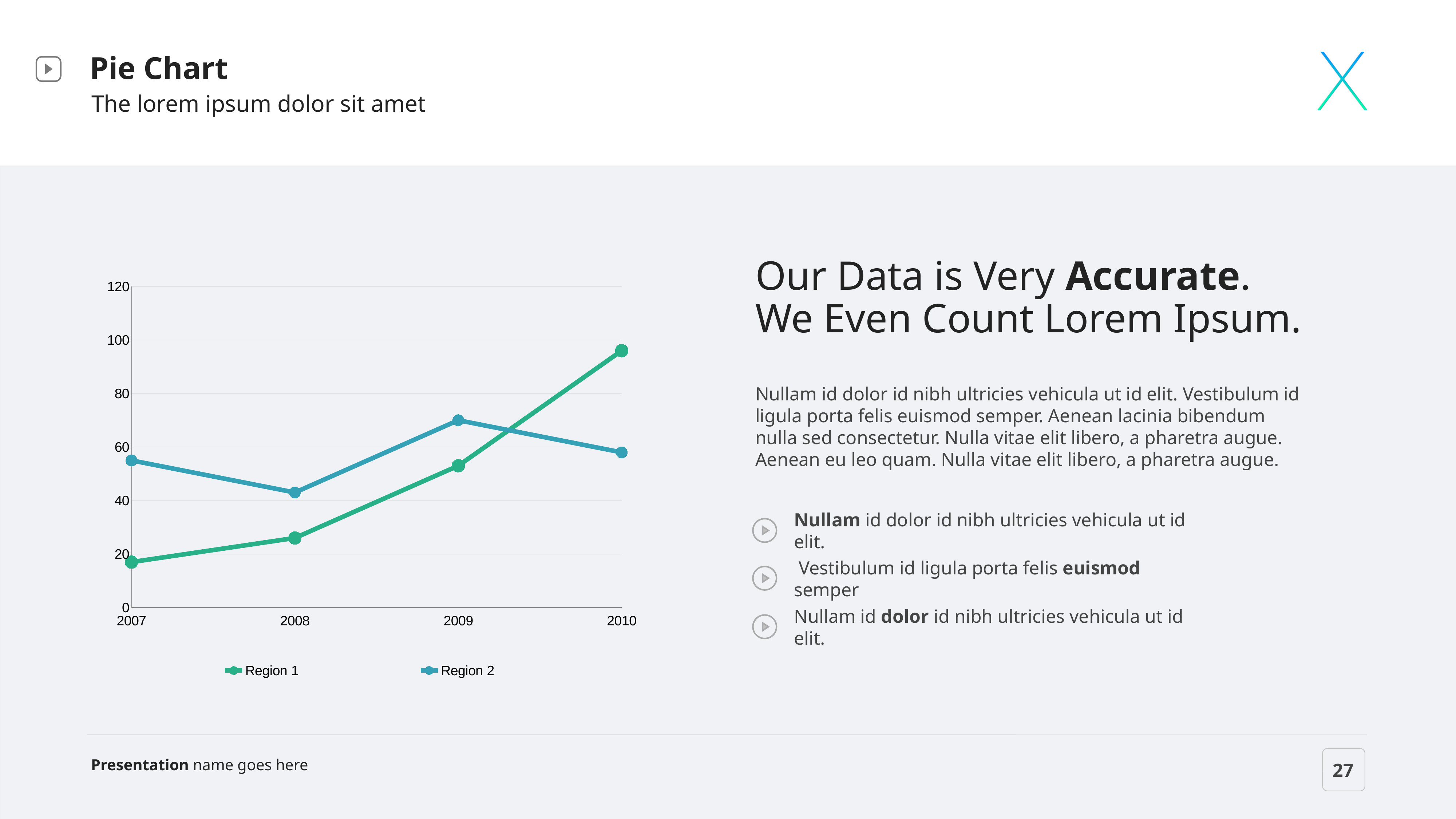
What kind of chart is shown on the slide? line chart What are the two series named in the chart's legend? Region 1 and Region 2 How many series does the chart's legend list? 2 Is the value for Region 1 in 2010 greater or less than 80? greater How many years are plotted along the x axis of the chart? 4 In which year does Region 2 have its lowest value? 2008 In 2007, which series has the larger value, Region 1 or Region 2? Region 2 In which year does Region 1 reach its highest value? 2010 Is the value for Region 1 in 2007 greater or less than 20? less In which year does Region 1 have its lowest value? 2007 In which year does Region 2 reach its highest value? 2009 Does the Region 1 line rise or fall from 2007 to 2010? rises